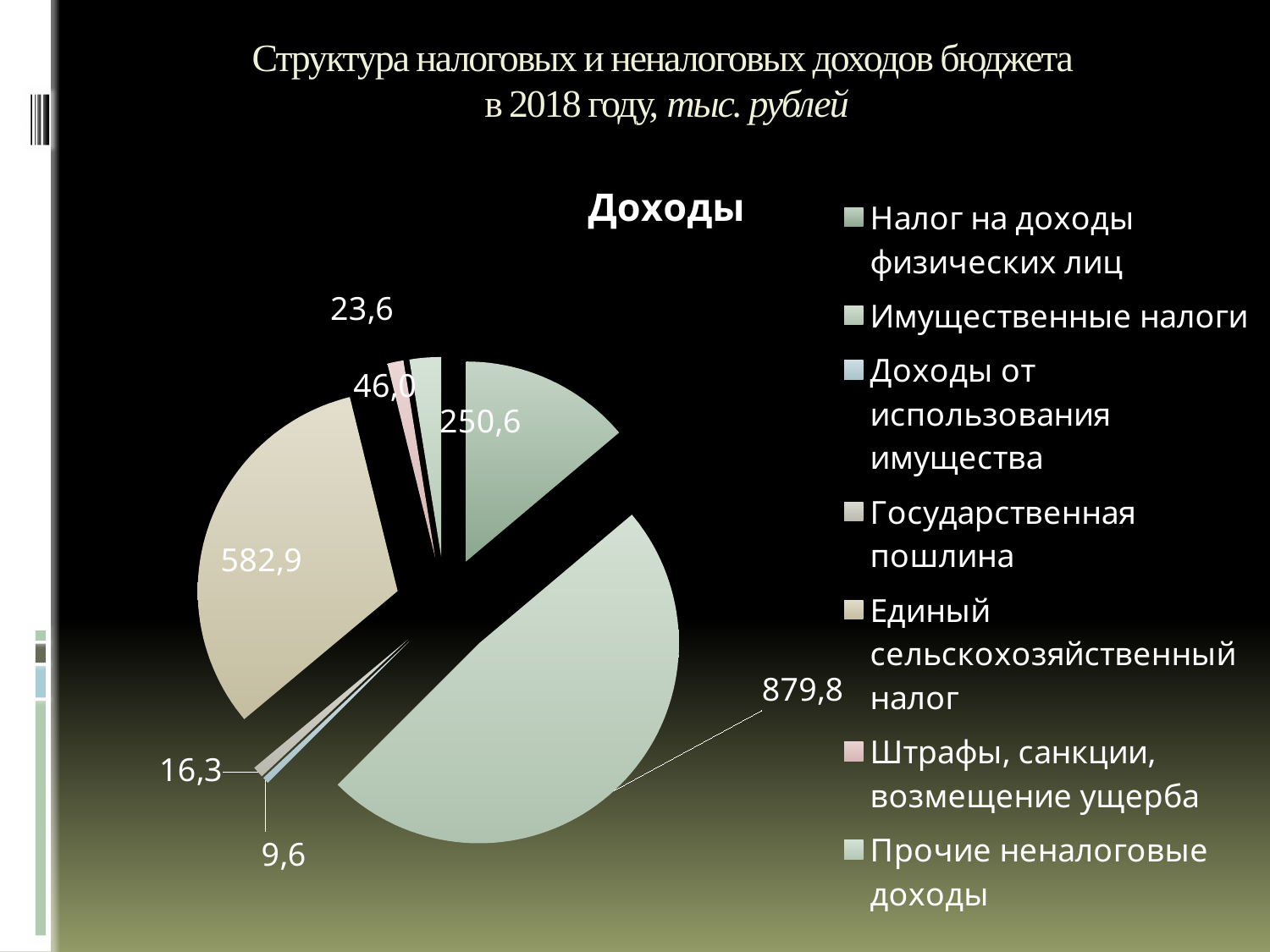
What is the difference between the values for Имущественные налоги and Единый сельскохозяйственный налог? 296,9 Which category has the largest slice of the pie? Имущественные налоги What is the value for Штрафы, санкции, возмещение ущерба? 23,6 Which category has the smallest slice of the pie? Доходы от использования имущества How many categories does the legend list? 7 What is the value for Налог на доходы физических лиц? 250,6 What is the value for Единый сельскохозяйственный налог? 582,9 Which is larger: Государственная пошлина or Прочие неналоговые доходы? Прочие неналоговые доходы What is the title of the chart? Доходы What is the value for Имущественные налоги? 879,8 What kind of chart is shown on the slide? pie chart What is the value for Доходы от использования имущества? 9,6